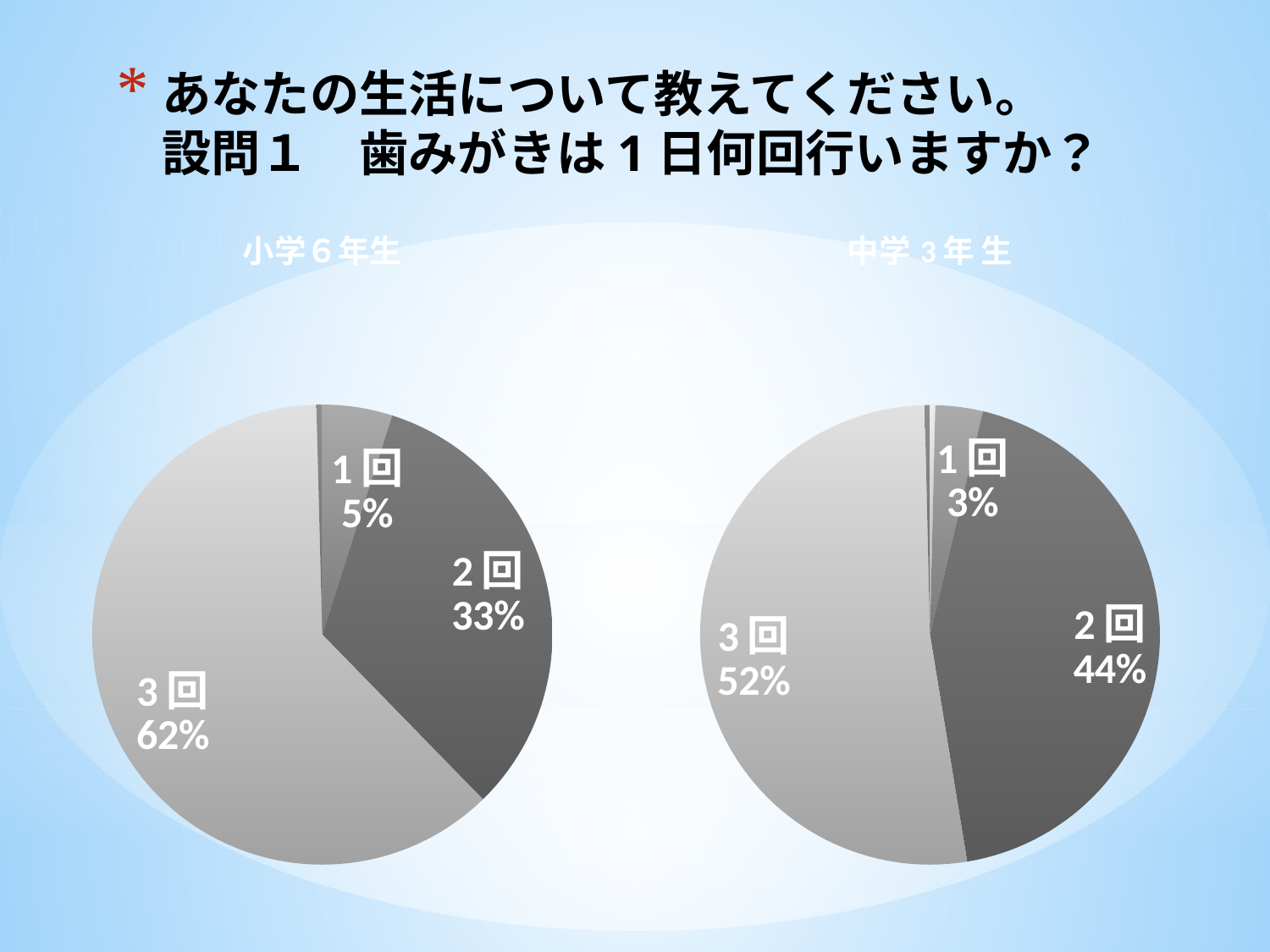
In the 小学６年生 pie chart, which category has the largest slice? 3回 What kind of chart is used on the left of the slide? Pie chart In the 小学６年生 pie chart, what is the difference between the shares for 3回 and 2回? 29% In the 小学６年生 pie chart, what share is labelled for 1回? 5% In the 中学３年生 pie chart, what share is labelled for 2回? 44% Which is larger: the 2回 share in the 小学６年生 chart or the 2回 share in the 中学３年生 chart? 中学３年生 In the 中学３年生 pie chart, what share is labelled for 1回? 3% In the 中学３年生 pie chart, what is the difference between the shares for 3回 and 2回? 8% What is the title of the pie chart on the right? 中学３年生 In the 小学６年生 pie chart, what share is labelled for 3回? 62%